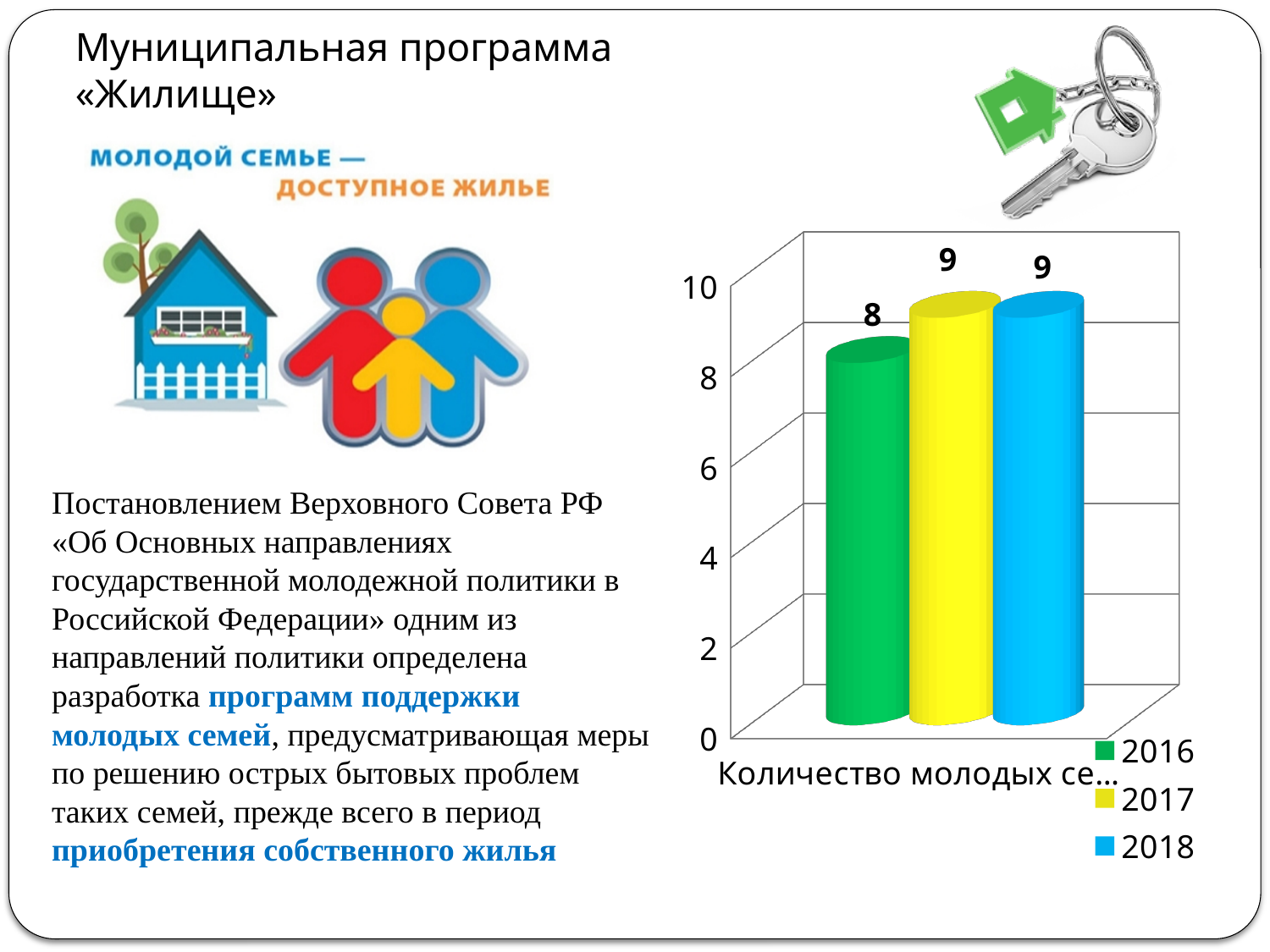
What kind of chart is shown on the slide? bar chart How many series does the legend list? 3 What is the value for the 2017 series in the chart? 9 What are the entries listed in the chart legend? 2016, 2017, 2018 Which is larger, the value for 2016 or the value for 2017? 2017 What is the difference between the values for 2017 and 2016? 1 Is the value for 2016 greater or less than 10? less How many categories are shown on the x axis of the chart? 1 Which colour represents the 2016 series in the chart? green Which series has the lowest value in the chart? 2016 What is the value for the 2018 series in the chart? 9 What is the value for the 2016 series in the chart? 8